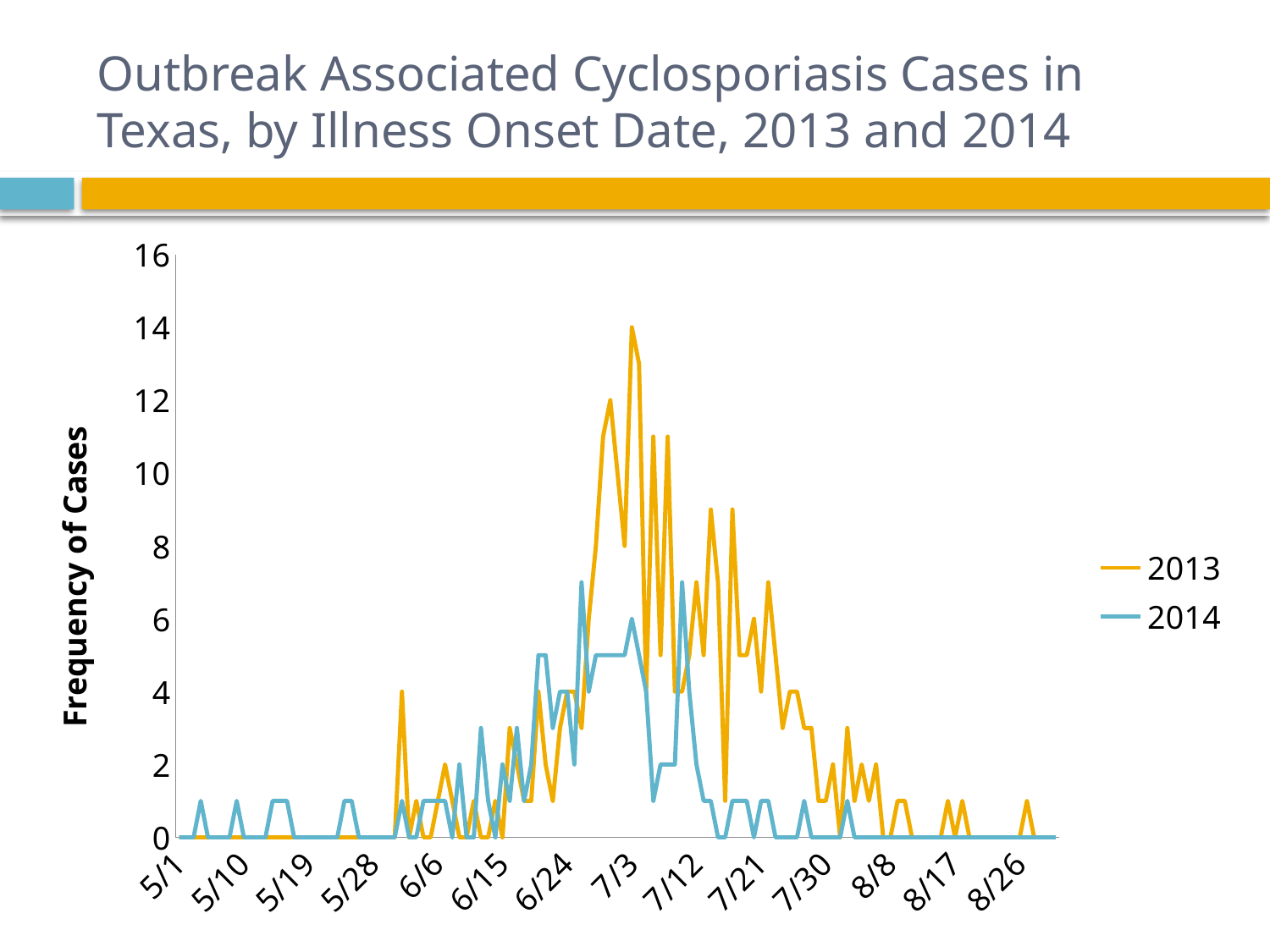
Is the highest value reached by the 2014 line greater or less than 10? less Which series reaches the highest peak on the chart? 2013 Is the highest value reached by the 2014 line greater or less than 4? greater After 7/21, does the 2013 line generally rise or fall toward the end of August? fall How many date labels are shown on the x axis? 14 What kind of chart is shown on the slide? line chart Is the highest value reached by the 2013 line greater or less than 10? greater What are the two series named in the legend? 2013 and 2014 What is the title of the vertical axis? Frequency of Cases What is the highest value reached by the 2013 line? 14 Around 7/3, which series has the higher number of cases, 2013 or 2014? 2013 How many series does the legend list? 2